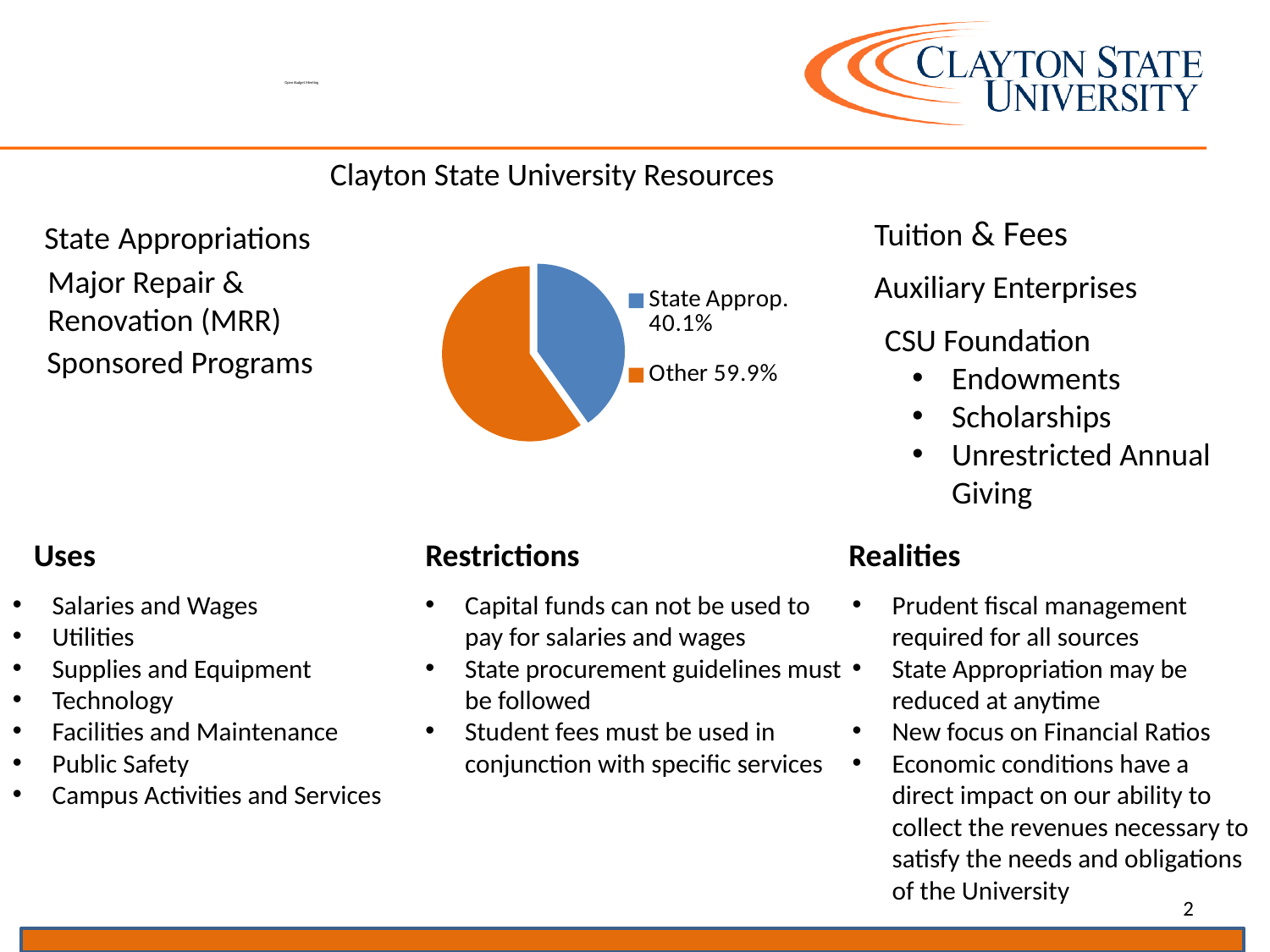
Which slice of the pie is the largest? Other How many slices does the pie chart have? 2 Is the State Approp. share greater or less than 50%? less What kind of chart is shown on the slide? pie chart What colour is the Other slice in the pie chart? orange Which slice of the pie is the smallest? State Approp. How many entries does the legend list? 2 Which is larger, the State Approp. slice or the Other slice? Other What share of the pie does Other represent? 59.9% What colour is the State Approp. slice in the pie chart? blue What share of the pie does State Approp. represent? 40.1% What is the difference in percentage points between the Other slice and the State Approp. slice? 19.8